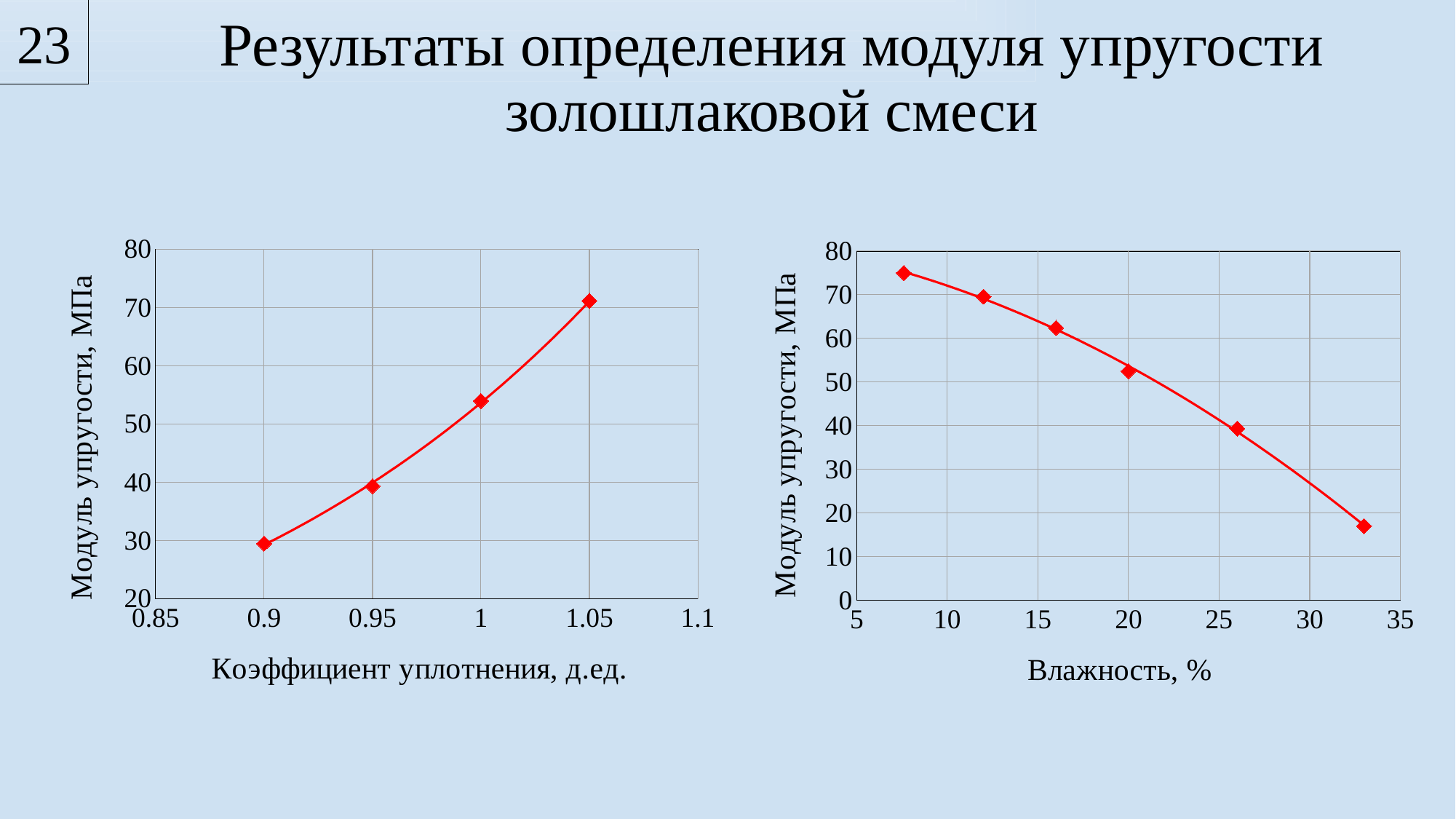
On the right chart (Влажность), is the value at 20% moisture greater or less than 60? less On the left chart (Коэффициент уплотнения), does the modulus of elasticity rise or fall as the compaction coefficient increases? rise What kind of chart is the left chart (Коэффициент уплотнения)? line chart On the right chart (Влажность), does the modulus of elasticity rise or fall as moisture increases? fall On the left chart (Коэффициент уплотнения), is the value at a compaction coefficient of 1.05 greater or less than 60? greater On the left chart (Коэффициент уплотнения), at which compaction coefficient is the modulus of elasticity highest? 1.05 How many data points are plotted on the right chart (Влажность)? 6 On the left chart (Коэффициент уплотнения), is the value at a compaction coefficient of 1 greater or less than 50? greater On the left chart (Коэффициент уплотнения), at which compaction coefficient is the modulus of elasticity lowest? 0.9 What is the y-axis label of the right chart (Влажность)? Модуль упругости, МПа How many data points are plotted on the left chart (Коэффициент уплотнения)? 4